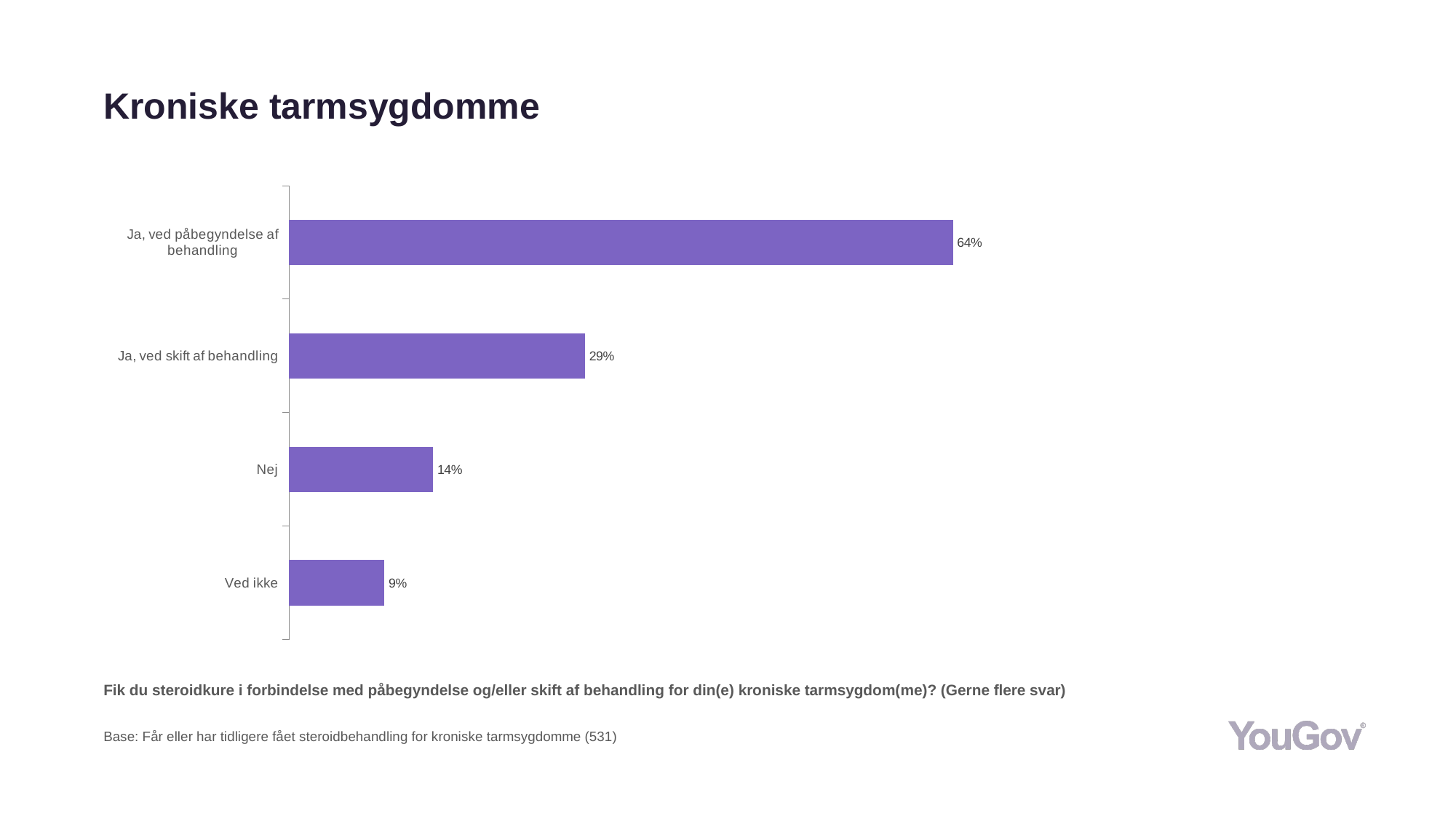
What kind of chart is shown on the slide? Bar chart What is the value for "Ja, ved påbegyndelse af behandling"? 64% What is the value for "Ved ikke"? 9% Which is larger, the value for "Ja, ved skift af behandling" or the value for "Nej"? Ja, ved skift af behandling Which category has the highest value? Ja, ved påbegyndelse af behandling What is the value for "Nej"? 14% What is the difference between "Nej" and "Ved ikke"? 5 percentage points What is the base size stated below the chart? 531 What is the value for "Ja, ved skift af behandling"? 29% Which category has the lowest value? Ved ikke How many categories are shown in the chart? 4 What is the difference between "Ja, ved påbegyndelse af behandling" and "Ja, ved skift af behandling"? 35 percentage points